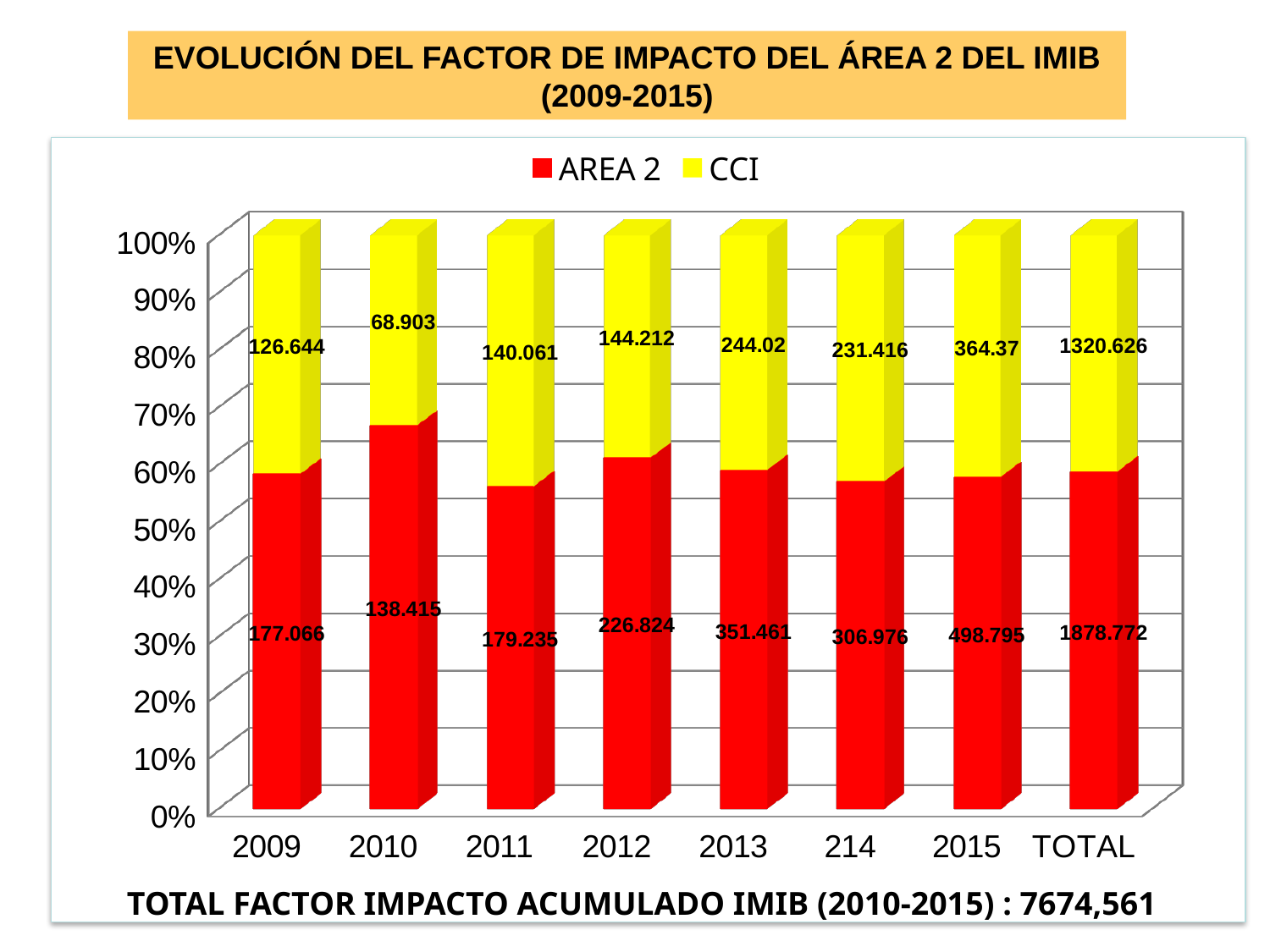
What is the sum of the AREA 2 and CCI values for 2009? 303.71 What is the difference between the AREA 2 value and the CCI value for 2015? 134.425 How many series does the legend list? 2 What is the AREA 2 value shown for the TOTAL bar? 1878.772 Is the AREA 2 share of the 2010 bar greater or less than 60%? greater Which is larger for 2013, the AREA 2 value or the CCI value? AREA 2 Among the individual years (excluding TOTAL), which year has the highest AREA 2 value? 2015 What is the AREA 2 value for 2009? 177.066 What is the CCI value for 2012? 144.212 How many bars are shown on the x axis? 8 What kind of chart is shown on the slide? Stacked bar chart Among the individual years (excluding TOTAL), which year has the lowest CCI value? 2010